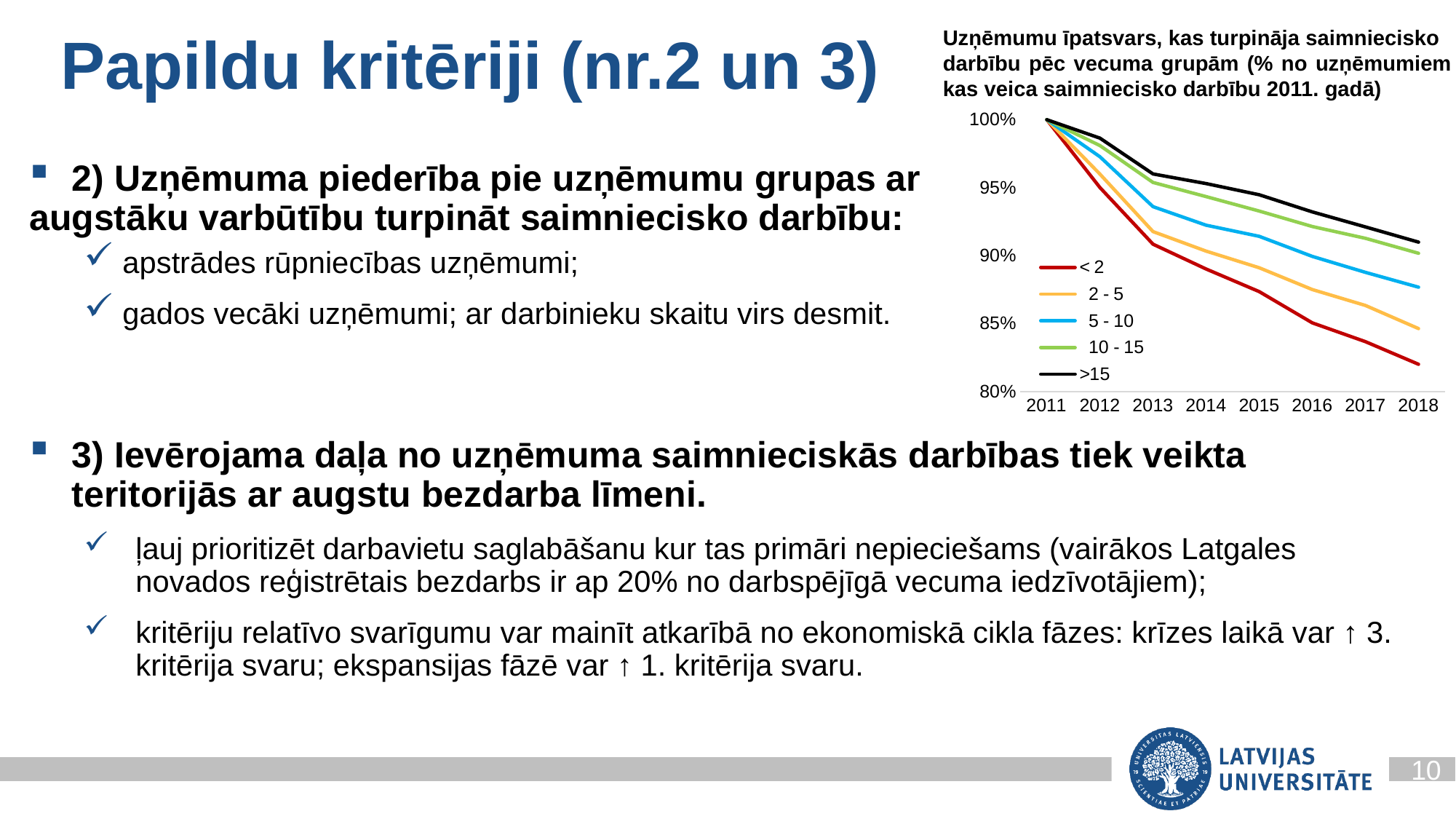
Which is larger in 2018, the value for the < 2 series or the >15 series? >15 Is the value for the < 2 series in 2014 greater or less than 90%? less Is the value for the < 2 series in 2018 greater or less than 85%? less What kind of chart is shown on the slide? line chart Which age group series has the highest value in 2018? >15 Is the value for the >15 series in 2018 greater or less than 90%? greater How many series does the chart legend list? 5 Which age group series has the lowest value in 2018? < 2 How many years are shown on the x axis of the chart? 8 What is the value for the >15 series in 2011? 100% Do the values for the < 2 series rise or fall from 2011 to 2018? fall